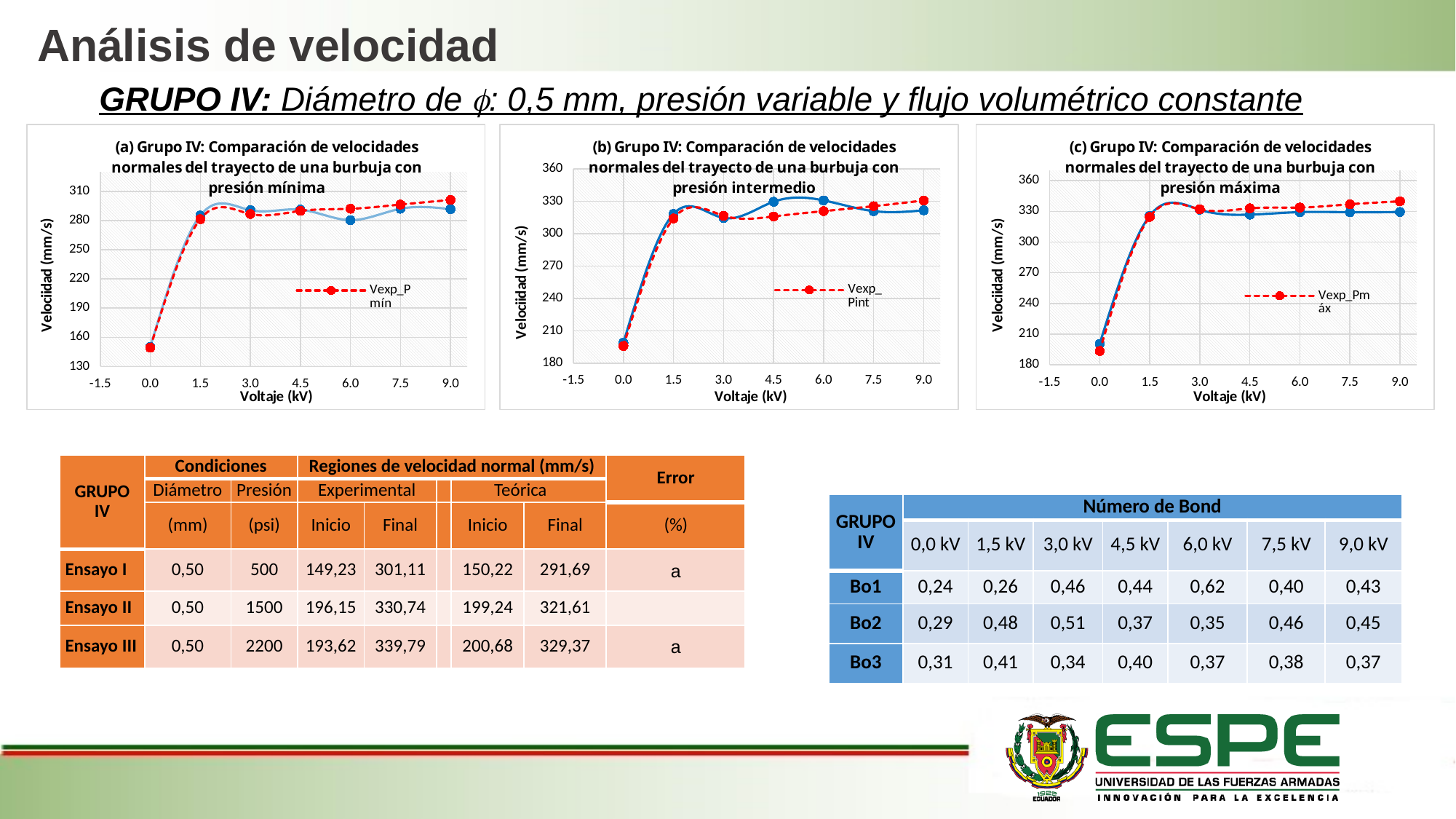
In the left chart (presión mínima), is the velocity at 0.0 kV greater or less than 160? less In the middle chart (presión intermedio), is the velocity at 0.0 kV greater or less than 210? less In the right chart (presión máxima), is the velocity at 1.5 kV greater or less than 300? greater How many voltage data points are plotted in the middle chart (presión intermedio)? 7 What is the x-axis label of the right chart (presión máxima)? Voltaje (kV) What kind of chart is the chart titled "(a) Grupo IV: Comparación de velocidades normales del trayecto de una burbuja con presión mínima"? line chart What is the y-axis label of the left chart (presión mínima)? Velociidad (mm/s) In the middle chart (presión intermedio), at which voltage is the velocity lowest? 0.0 kV In the left chart (presión mínima), at which voltage is the velocity lowest? 0.0 kV In the right chart (presión máxima), does the velocity rise or fall between 0.0 kV and 1.5 kV? rise